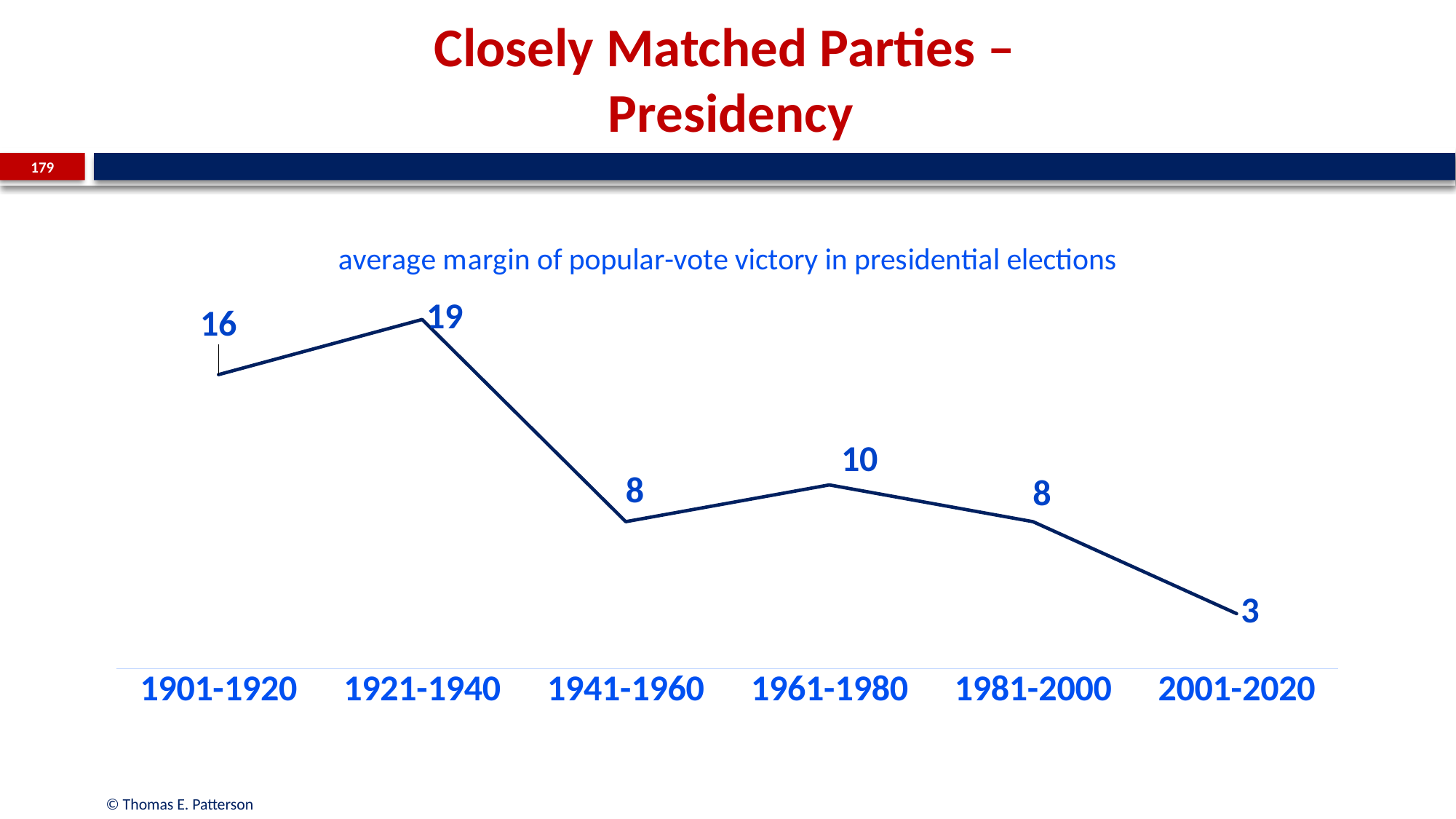
What is the average margin of popular-vote victory for 2001-2020? 3 What is the average margin of popular-vote victory for 1961-1980? 10 Does the average margin of popular-vote victory generally rise or fall from 1921-1940 to 2001-2020? fall What is the difference between the average margin for 1961-1980 and for 1981-2000? 2 Which period has the highest average margin of popular-vote victory? 1921-1940 What kind of chart is shown on the slide? line chart Which period has a larger average margin, 1901-1920 or 1961-1980? 1901-1920 What is the average margin of popular-vote victory for 1921-1940? 19 What is the average margin of popular-vote victory for 1901-1920? 16 Which period has the lowest average margin of popular-vote victory? 2001-2020 What is the difference between the average margin for 1921-1940 and for 2001-2020? 16 How many time periods are plotted on the chart? 6